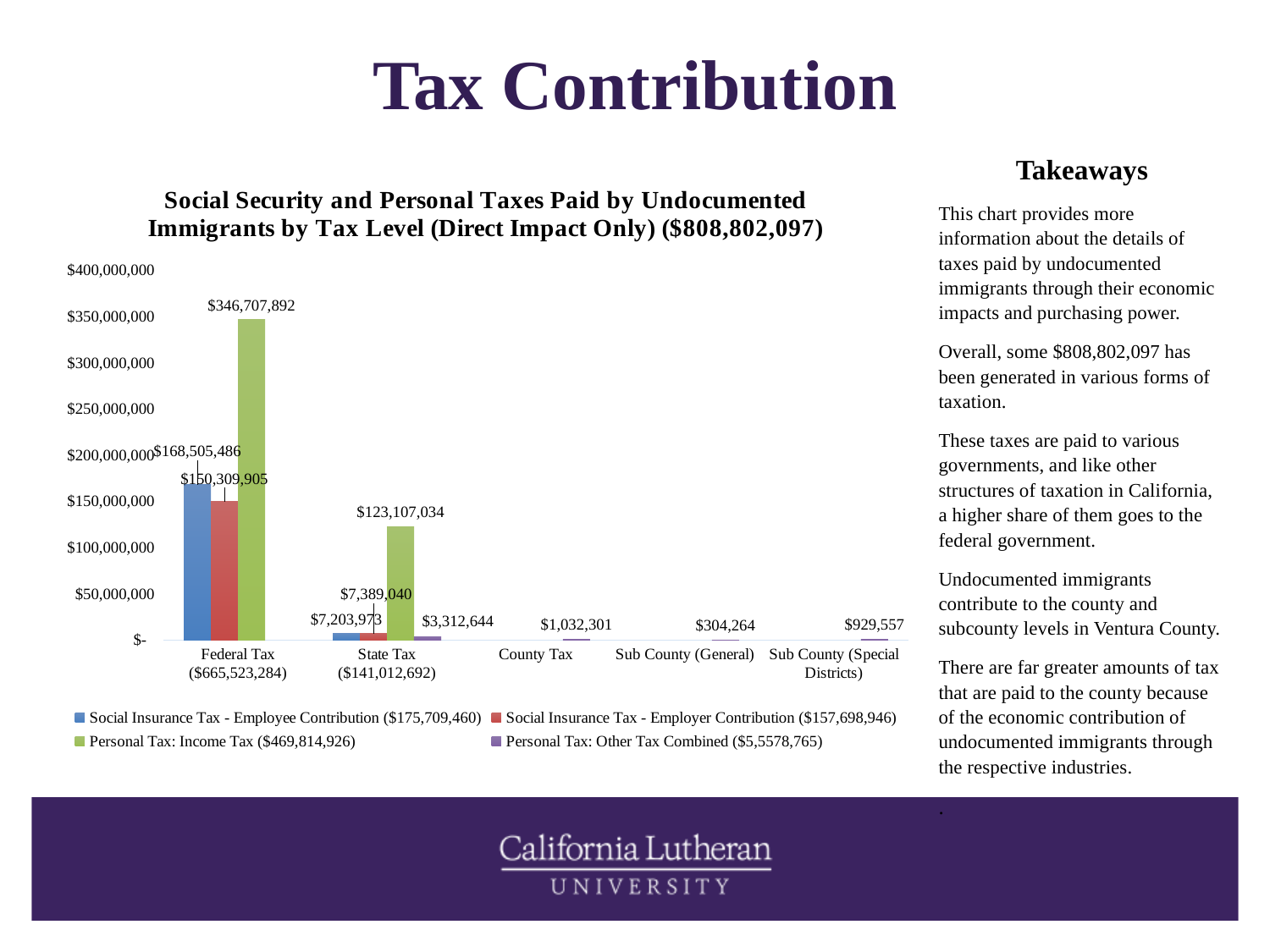
Which is larger, the value for Sub County (Special Districts) or the value for Sub County (General)? Sub County (Special Districts) What is the Personal Tax: Income Tax value for State Tax? $123,107,034 What is the Social Insurance Tax - Employer Contribution value for State Tax? $7,389,040 What is the difference between the Personal Tax: Income Tax and the Social Insurance Tax - Employee Contribution values for Federal Tax? $178,202,406 What is the value of Personal Tax: Income Tax for Federal Tax? $346,707,892 Is the Personal Tax: Income Tax value for State Tax greater or less than $150,000,000? less Which tax level has the tallest bar in the chart? Federal Tax What value is labelled for County Tax? $1,032,301 How many tax level categories are shown on the x axis? 5 What is the Social Insurance Tax - Employee Contribution value for Federal Tax? $168,505,486 What type of chart is shown on the slide? Bar chart How many series does the legend list? 4